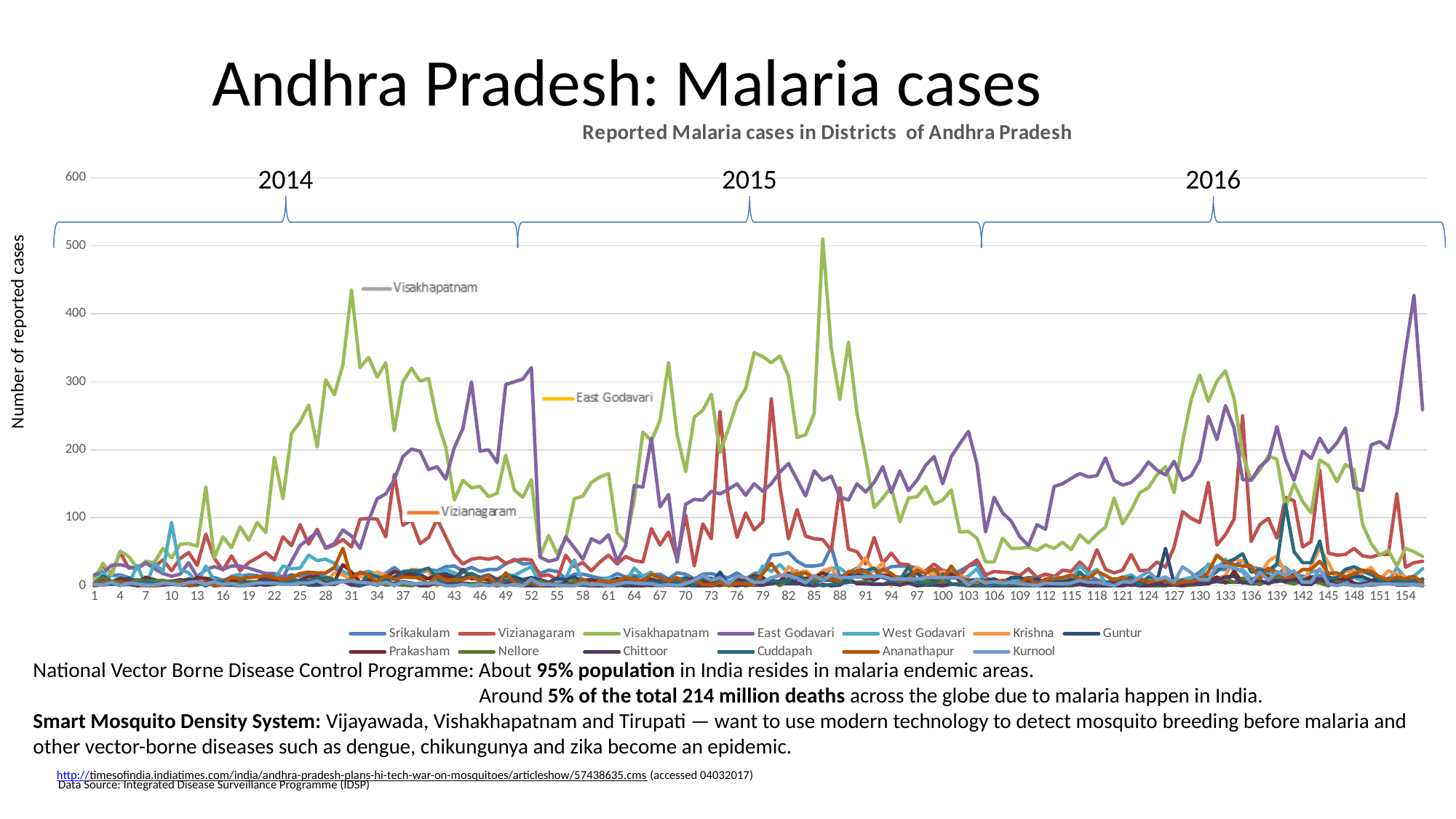
What is the title of the chart? Reported Malaria cases in Districts of Andhra Pradesh What is the last tick label shown on the horizontal axis? 154 Is the peak value for East Godavari near the end of the series (around week 154) greater or less than 300? greater Around week 86, which series is higher: Visakhapatnam or Vizianagaram? Visakhapatnam Which three years are marked above the chart? 2014, 2015, 2016 What kind of chart is shown on the slide? line chart Is the value for Visakhapatnam at week 31 greater or less than 400? greater Which district's series reaches the highest value anywhere on the chart? Visakhapatnam What is the label of the vertical axis? Number of reported cases How many series does the chart's legend list? 13 What is the highest tick value shown on the vertical axis? 600 Is the peak value for Visakhapatnam around week 86 greater or less than 400? greater